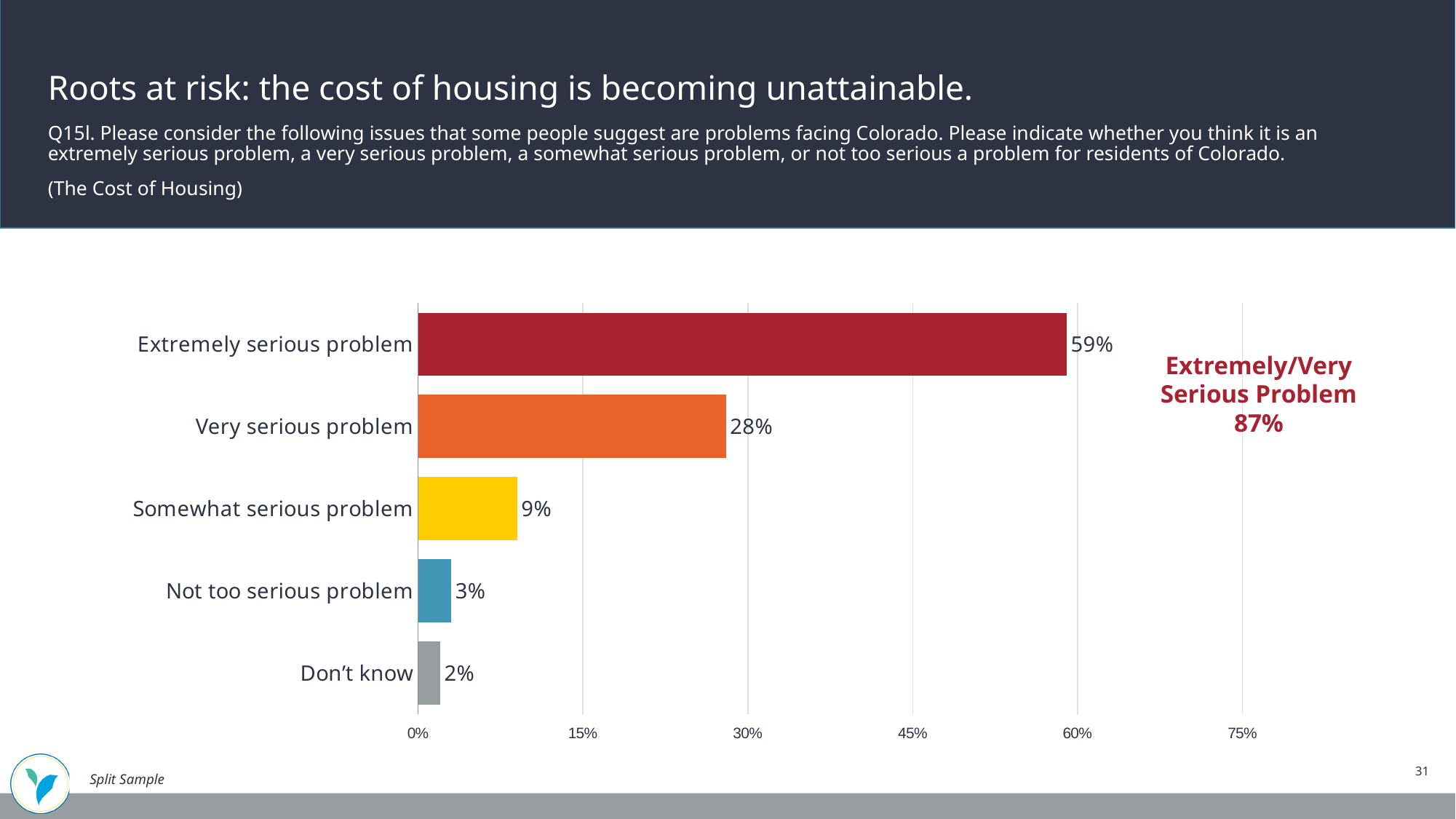
Which category has the highest value? Extremely serious problem What is the difference between 'Extremely serious problem' and 'Very serious problem'? 31% Which is larger, 'Somewhat serious problem' or 'Not too serious problem'? Somewhat serious problem What combined percentage is shown for 'Extremely/Very Serious Problem'? 87% Is the value for 'Extremely serious problem' greater or less than 45%? greater How many categories are shown in the chart? 5 What is the value for 'Somewhat serious problem'? 9% What is the value for 'Very serious problem'? 28% Which category has the lowest value? Don't know What kind of chart is shown on the slide? Bar chart What percentage of respondents said the cost of housing is an extremely serious problem? 59% What is the value for 'Don't know'? 2%